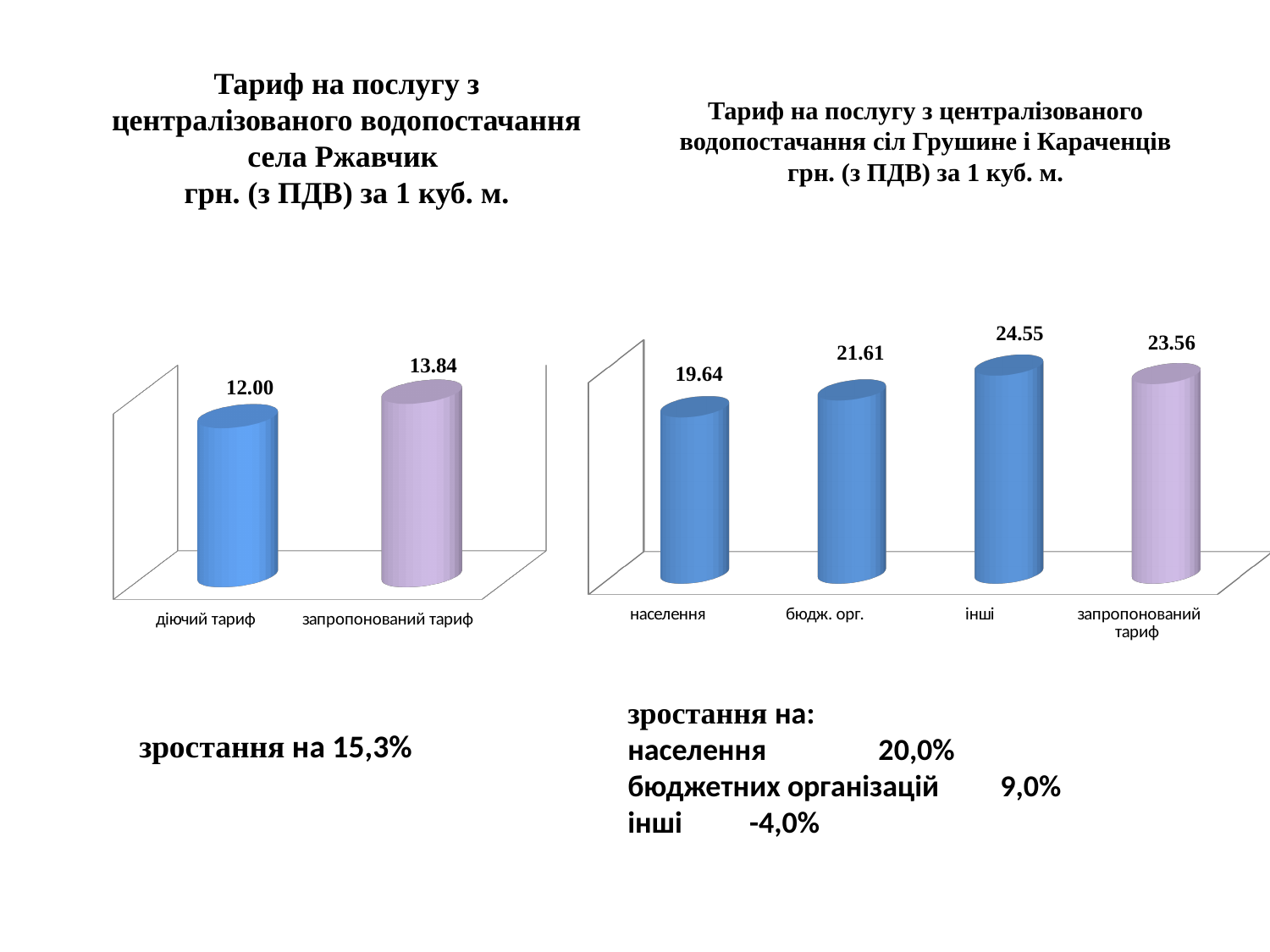
In the right chart (села Грушине і Караченців), what is the value for 'населення'? 19.64 In the left chart (село Ржавчик), what is the value for 'запропонований тариф'? 13.84 In the right chart (села Грушине і Караченців), which category has the highest value? інші In the right chart (села Грушине і Караченців), what is the value for 'запропонований тариф'? 23.56 In the right chart (села Грушине і Караченців), what is the value for 'бюдж. орг.'? 21.61 In the right chart (села Грушине і Караченців), how many categories are plotted? 4 In the left chart (село Ржавчик), what is the difference between 'запропонований тариф' and 'діючий тариф'? 1.84 In the left chart (село Ржавчик), how many categories are plotted? 2 What type of chart is the left chart (село Ржавчик)? Bar chart In the right chart (села Грушине і Караченців), which category has the lowest value? населення In the right chart (села Грушине і Караченців), what is the difference between 'інші' and 'населення'? 4.91 In the left chart (село Ржавчик), what is the value for 'діючий тариф'? 12.00